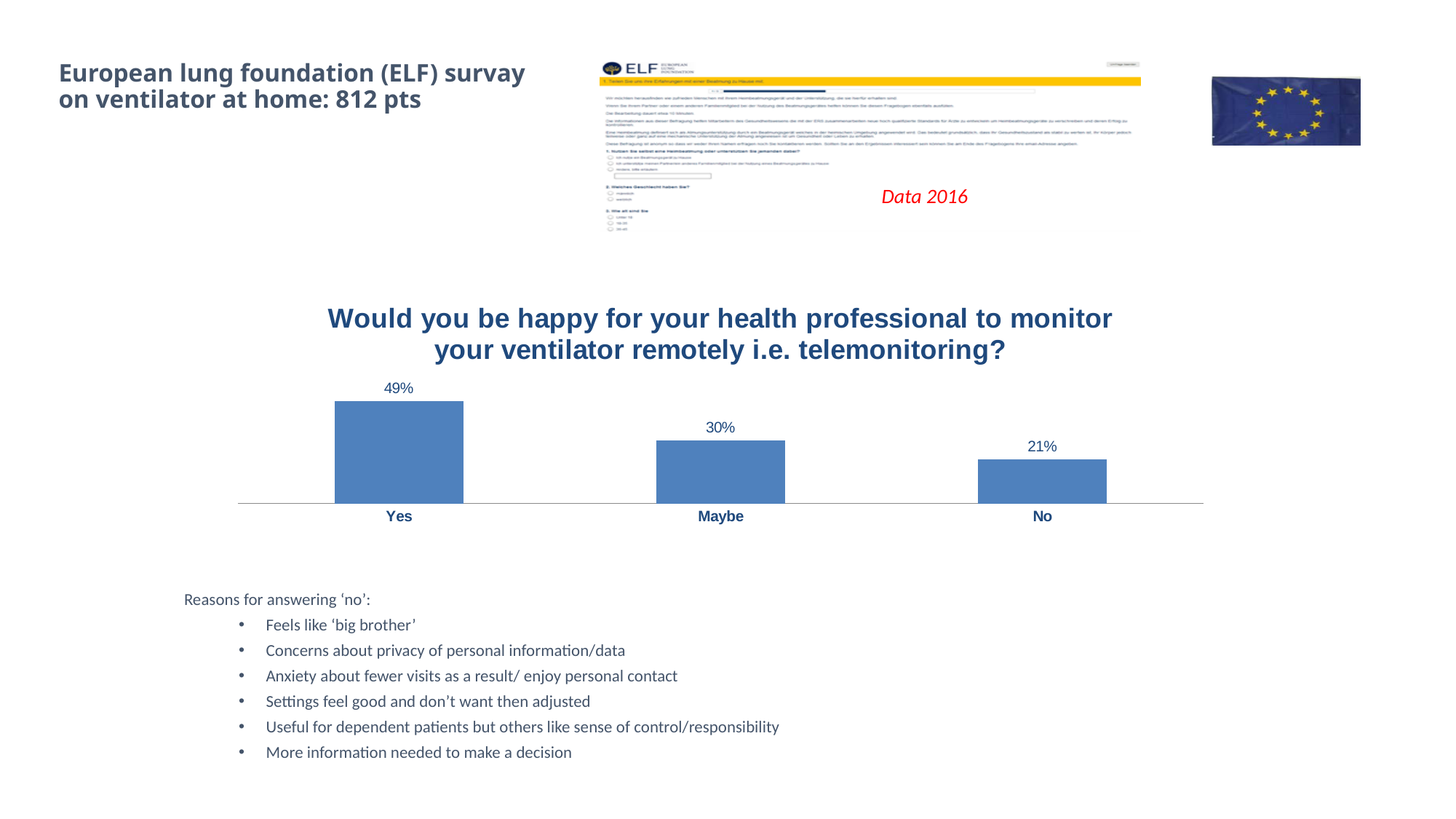
What question does the chart title ask? Would you be happy for your health professional to monitor your ventilator remotely i.e. telemonitoring? What kind of chart is used to show the survey responses? Bar chart Which response category has the lowest percentage? No What is the difference in percentage points between 'Maybe' and 'No'? 9 How many response categories are shown in the chart? 3 What percentage of respondents answered 'No'? 21% What is the difference in percentage points between 'Yes' and 'No'? 28 Which is larger, the value for 'Maybe' or the value for 'No'? Maybe Do the values rise or fall from left to right across the categories? Fall What percentage of respondents answered 'Yes'? 49% What percentage of respondents answered 'Maybe'? 30% Which response category has the highest percentage? Yes